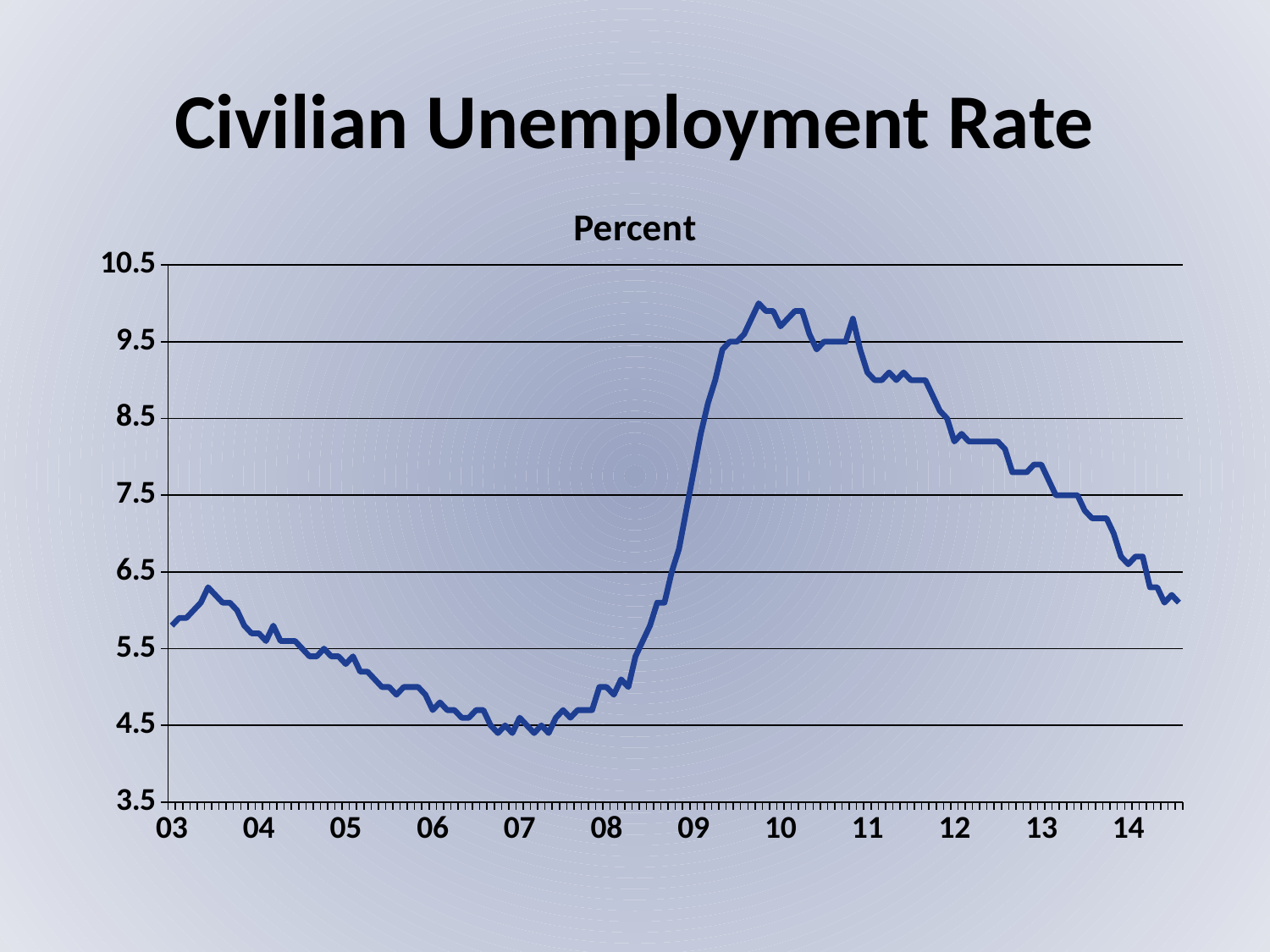
Is the unemployment rate at the start of 10 greater or less than 8.5? greater Is the unemployment rate at the start of 07 greater or less than 5.5? less How many year labels are shown along the x axis? 12 Is the unemployment rate at the start of 12 greater or less than 7.5? greater Does the unemployment rate rise or fall between 08 and 09? rise What kind of chart is shown on the slide? line chart Is the unemployment rate higher at the start of 10 or at the start of 07? 10 What is the title of the chart? Civilian Unemployment Rate Does the unemployment rate rise or fall between 11 and 14? fall What unit label is shown above the chart's plot area? Percent